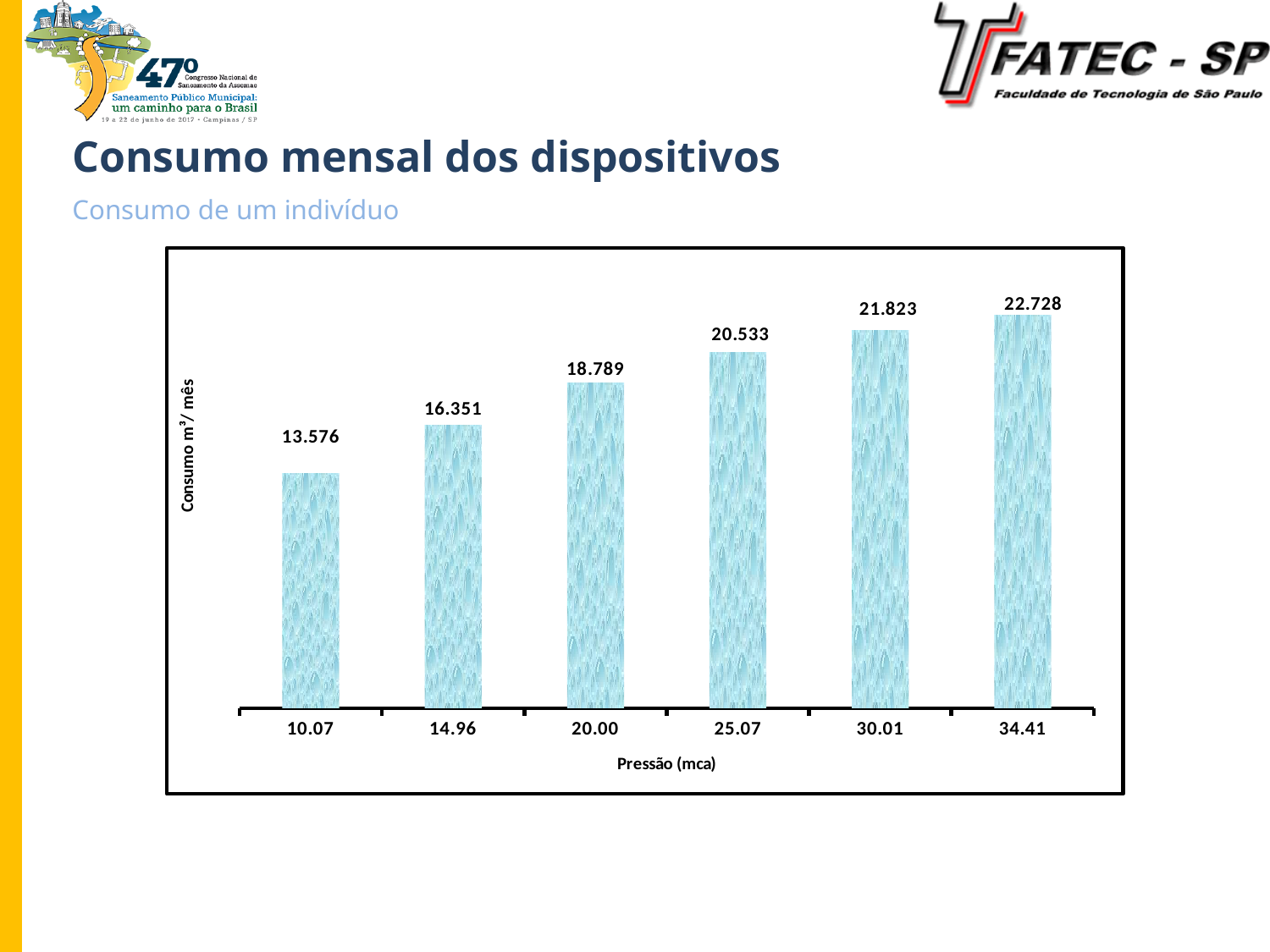
What is the consumption value at a pressure of 10.07 mca? 13.576 What is the label of the x axis? Pressão (mca) Which pressure value has the highest consumption? 34.41 What is the consumption value at a pressure of 25.07 mca? 20.533 What kind of chart is shown on the slide? Bar chart Which pressure value has the lowest consumption? 10.07 Which has a higher consumption value: 14.96 mca or 30.01 mca? 30.01 What is the consumption value at a pressure of 34.41 mca? 22.728 How many pressure categories are shown on the x axis? 6 Do the consumption values rise or fall as pressure increases along the x axis? Rise What is the difference between the consumption at 25.07 mca and at 20.00 mca? 1.744 What is the difference between the consumption at 34.41 mca and at 10.07 mca? 9.152